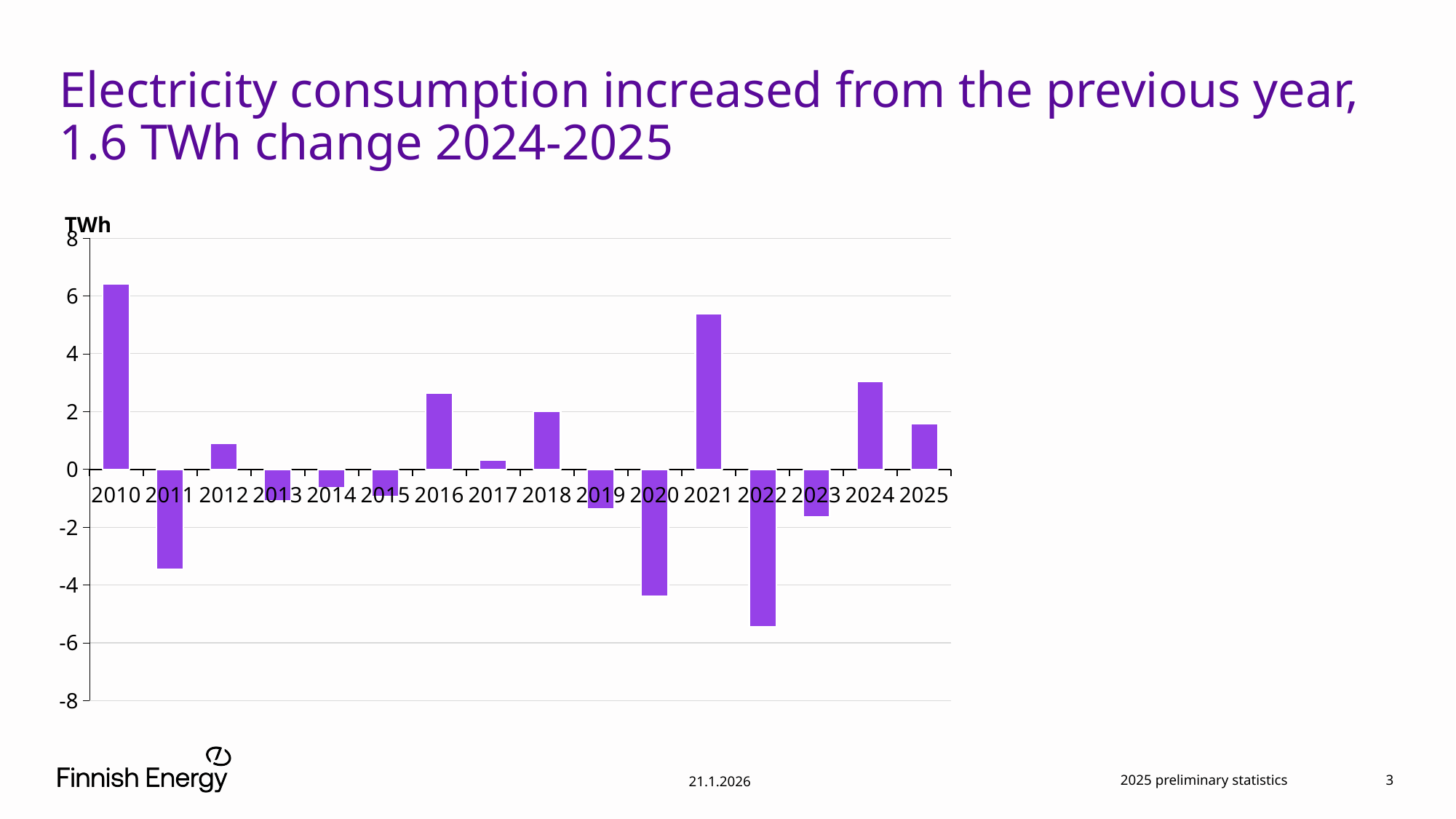
Which year has the highest value on the chart? 2010 Is the value for 2010 greater or less than 6? greater How many years are plotted on the chart? 16 Is the value for 2021 greater or less than 4? greater Which is larger, the value for 2016 or the value for 2018? 2016 Is the value for 2011 greater or less than -2? less Which is larger, the value for 2010 or the value for 2021? 2010 Which year has the lowest value on the chart? 2022 What kind of chart is shown on the slide? bar chart According to the slide, what is the change in electricity consumption from 2024 to 2025? 1.6 TWh What unit is shown on the vertical axis of the chart? TWh